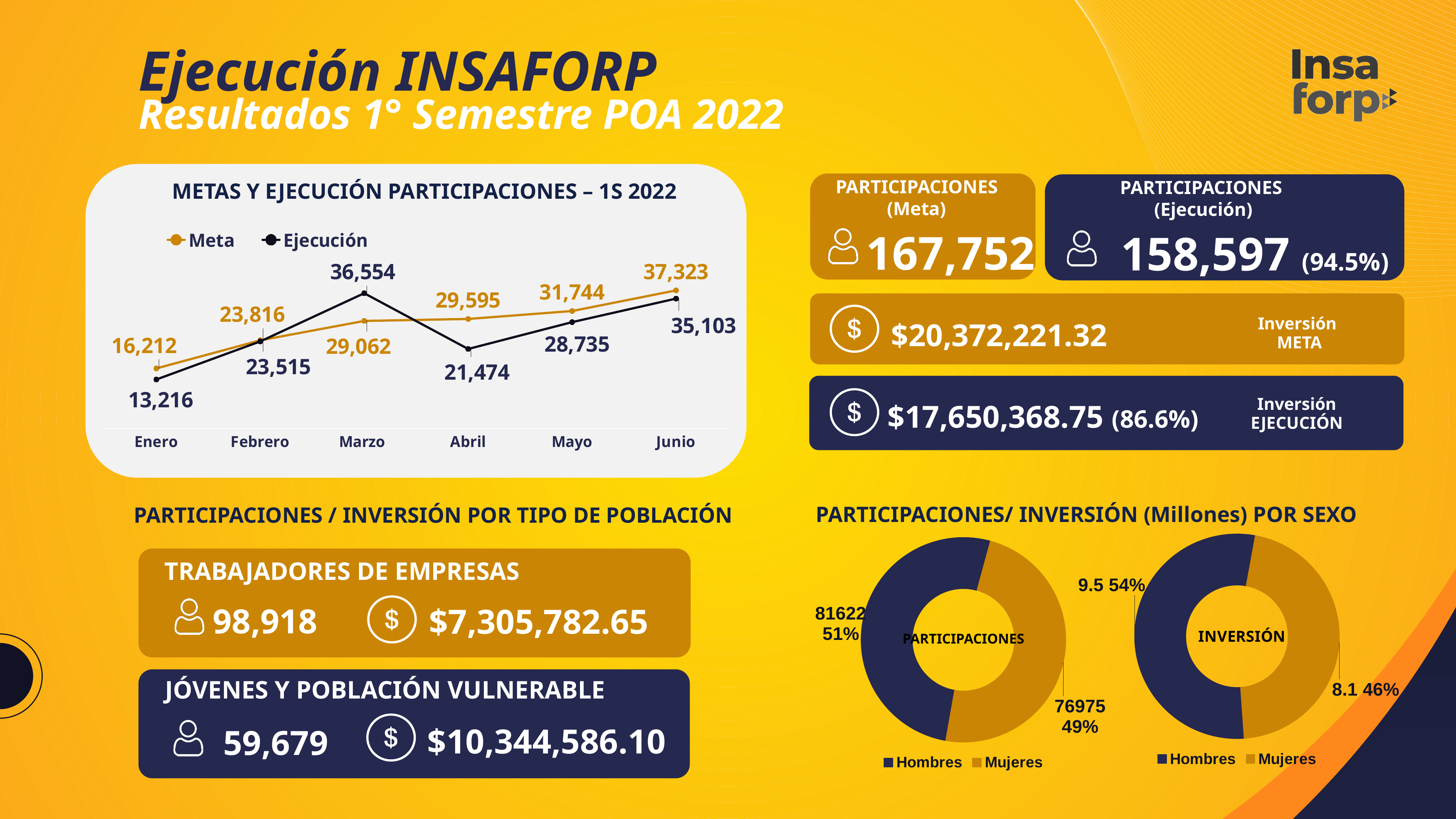
In the chart 'METAS Y EJECUCIÓN PARTICIPACIONES – 1S 2022', which is larger in Junio, Meta or Ejecución? Meta In the chart 'METAS Y EJECUCIÓN PARTICIPACIONES – 1S 2022', which month has the lowest Meta value? Enero In the chart 'METAS Y EJECUCIÓN PARTICIPACIONES – 1S 2022', how many series does the legend list? 2 In the PARTICIPACIONES donut chart under 'PARTICIPACIONES/ INVERSIÓN (Millones) POR SEXO', what share of participations corresponds to Hombres? 51% In the chart 'METAS Y EJECUCIÓN PARTICIPACIONES – 1S 2022', how many months are plotted on the x axis? 6 In the INVERSIÓN donut chart under 'PARTICIPACIONES/ INVERSIÓN (Millones) POR SEXO', what is the value for Mujeres? 8.1 What kind of chart is 'METAS Y EJECUCIÓN PARTICIPACIONES – 1S 2022'? Line chart In the chart 'METAS Y EJECUCIÓN PARTICIPACIONES – 1S 2022', what is the Ejecución value for Abril? 21,474 In the chart 'METAS Y EJECUCIÓN PARTICIPACIONES – 1S 2022', which month has the highest Ejecución value? Marzo In the chart 'METAS Y EJECUCIÓN PARTICIPACIONES – 1S 2022', does the Meta series rise or fall from Enero to Junio? Rise In the chart 'METAS Y EJECUCIÓN PARTICIPACIONES – 1S 2022', what is the Meta value for Marzo? 29,062 In the chart 'METAS Y EJECUCIÓN PARTICIPACIONES – 1S 2022', what is the difference between Ejecución and Meta in Marzo? 7,492